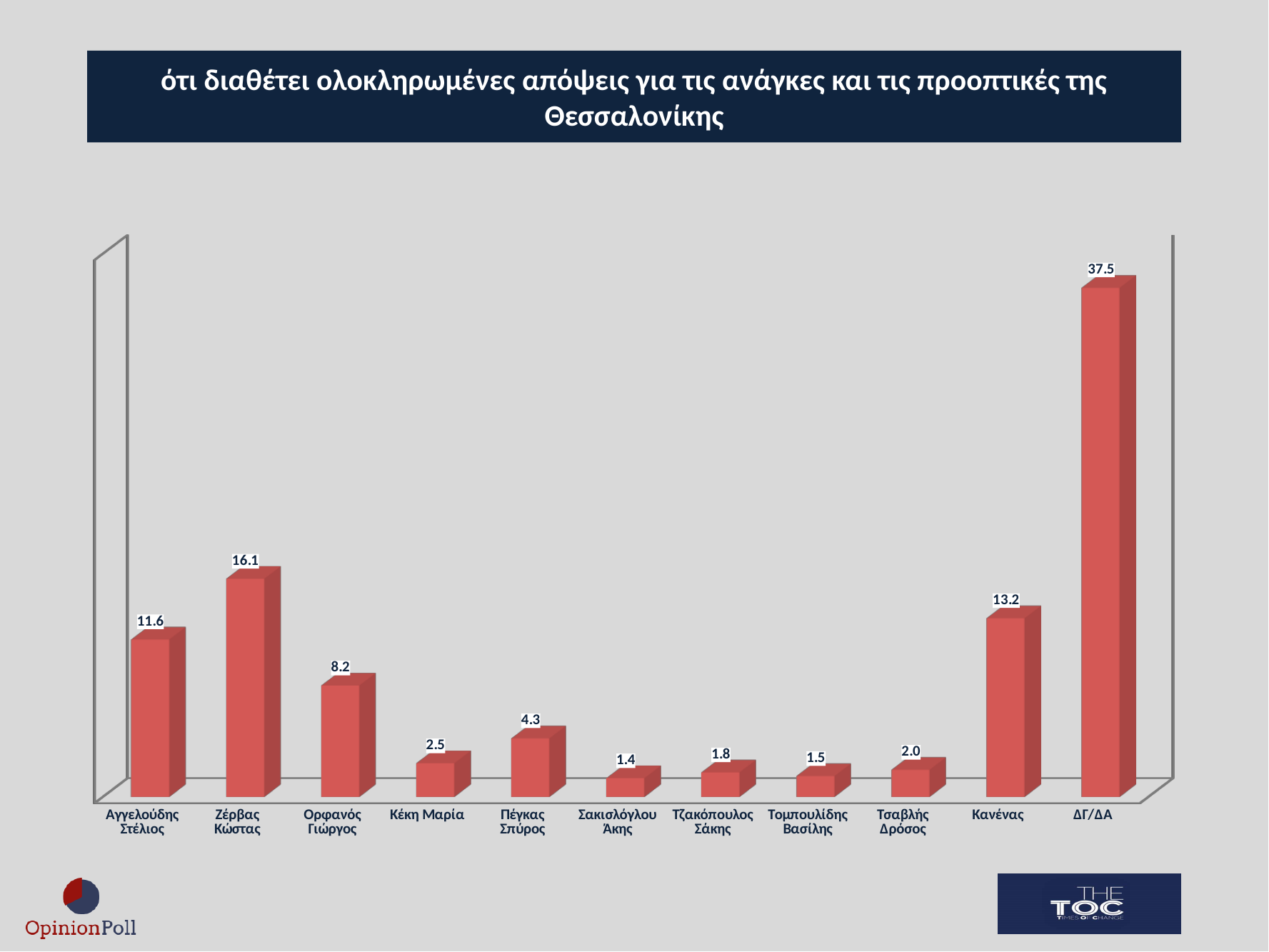
What kind of chart is shown on the slide? Bar chart What value is shown for Πέγκας Σπύρος? 4.3 What colour are the bars in the chart? Red What value is shown for ΔΓ/ΔΑ? 37.5 What value is shown for Ζέρβας Κώστας? 16.1 What value is shown for Ορφανός Γιώργος? 8.2 What is the difference between the values for Ζέρβας Κώστας and Αγγελούδης Στέλιος? 4.5 Which category has the highest value? ΔΓ/ΔΑ What value is shown for Κανένας? 13.2 Which is larger, the value for Κανένας or the value for Ζέρβας Κώστας? Ζέρβας Κώστας How many categories are shown on the x axis? 11 Which category has the lowest value? Σακισλόγλου Άκης